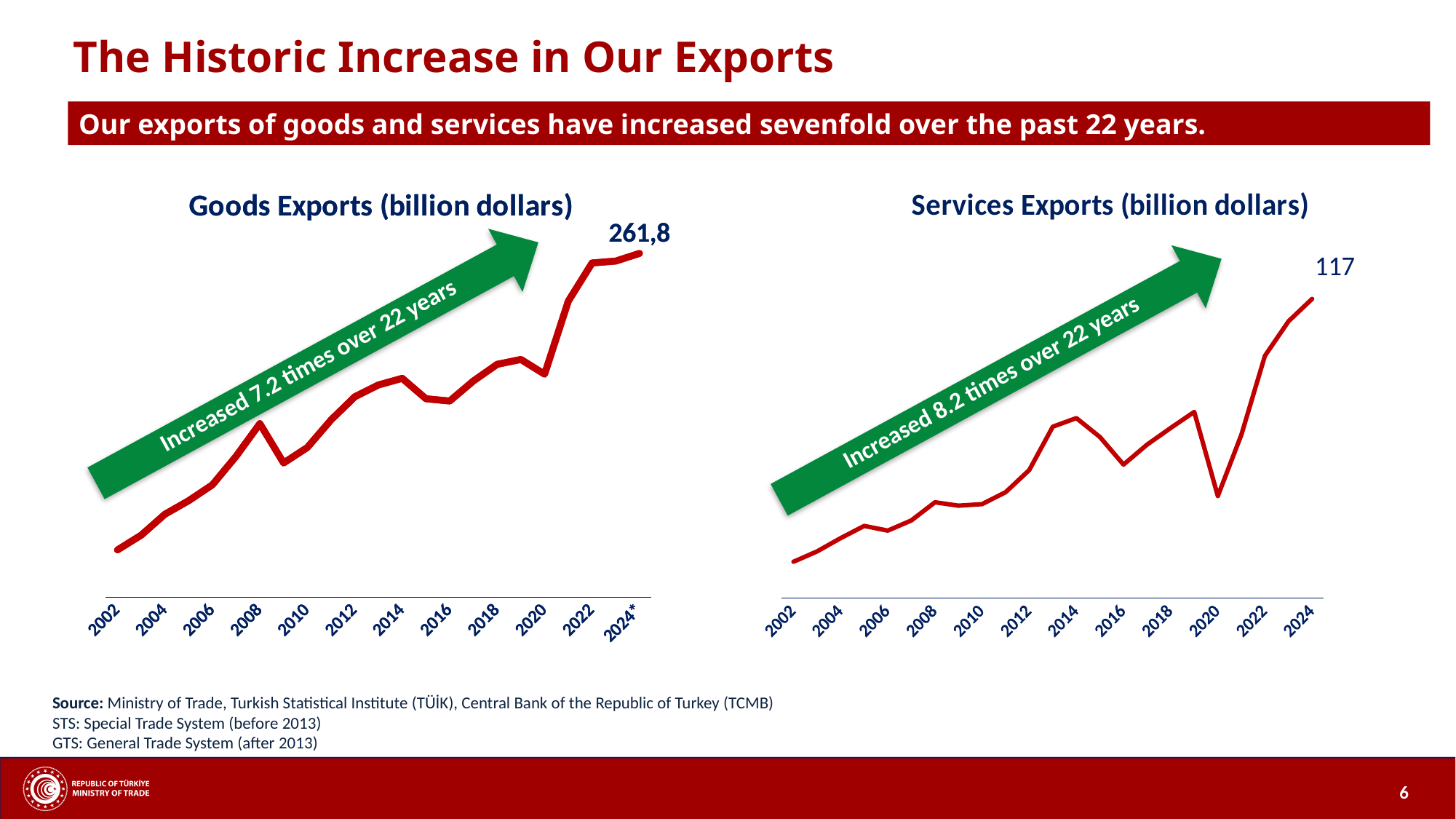
What kind of chart is the Goods Exports chart? Line chart On the Services Exports chart, which is larger: the value for 2014 or the value for 2020? 2014 On the Goods Exports chart, what is the value shown for 2024*? 261,8 On the Services Exports chart, what is the value shown for 2024? 117 On the Goods Exports chart, which year has the highest value? 2024* On the Services Exports chart, do the values generally rise or fall from 2002 to 2024? Rise On the Services Exports chart, which year has the lowest value? 2002 What does the green arrow on the Services Exports chart say? Increased 8.2 times over 22 years On the Goods Exports chart, which year has the lowest value? 2002 What is the difference between the 2024 value on the Goods Exports chart (261,8) and the 2024 value on the Services Exports chart (117)? 144,8 Which is larger: the 2024 value on the Goods Exports chart or the 2024 value on the Services Exports chart? Goods Exports On the Goods Exports chart, which is larger: the value for 2020 or the value for 2022? 2022